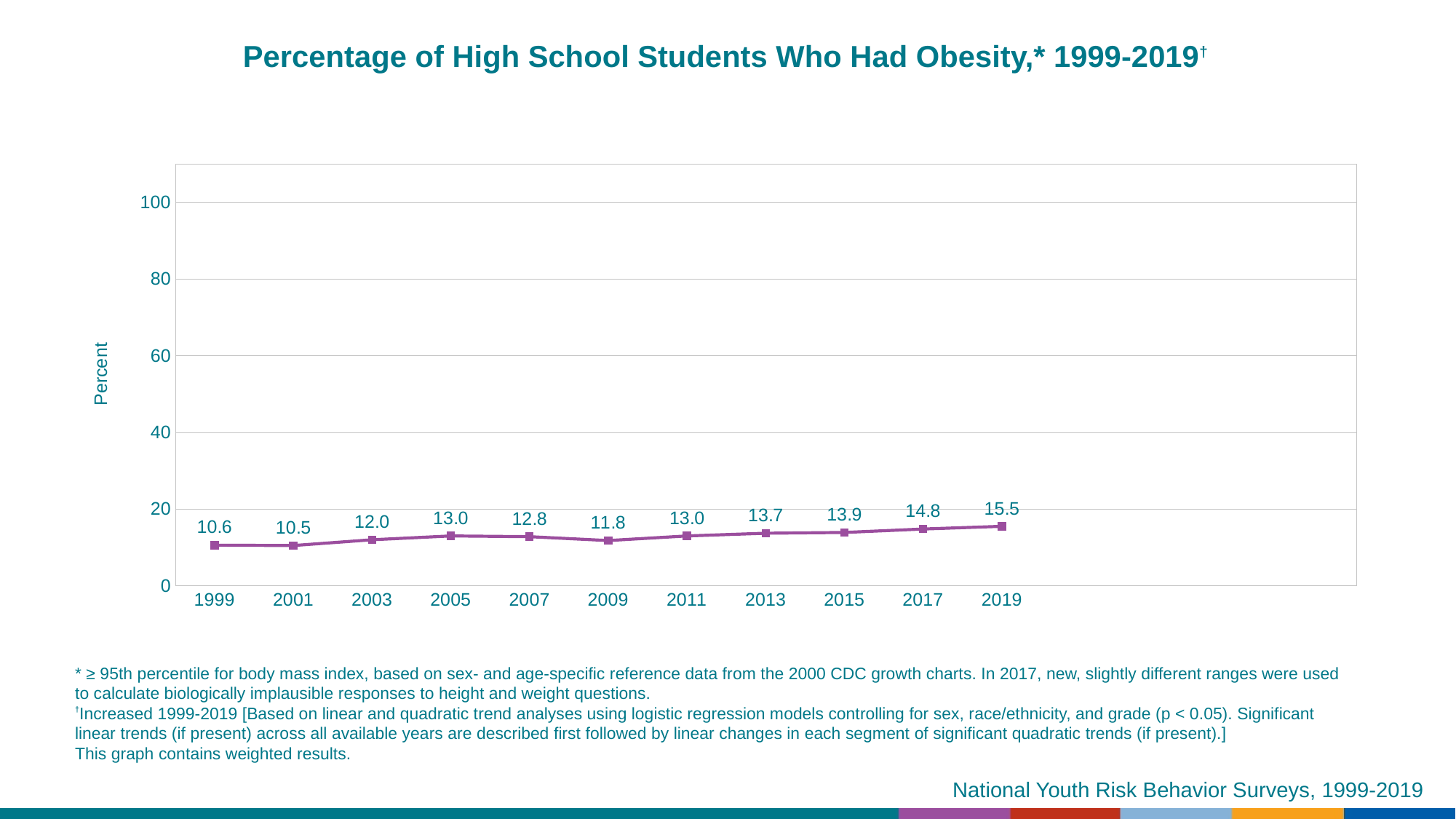
What value is shown for 2009? 11.8 What is the difference between the 2019 value and the 1999 value? 4.9 Is the value for 2019 greater or less than 20? less How many years are plotted on the x axis? 11 What is the label on the y axis? Percent Which year has a higher value, 2007 or 2009? 2007 Which year has the highest percentage of students who had obesity? 2019 What kind of chart is shown on the slide? line chart Which year has the lowest percentage of students who had obesity? 2001 What was the percentage of high school students who had obesity in 2019? 15.5 Do the values generally rise or fall from 1999 to 2019? rise What was the percentage of high school students who had obesity in 1999? 10.6